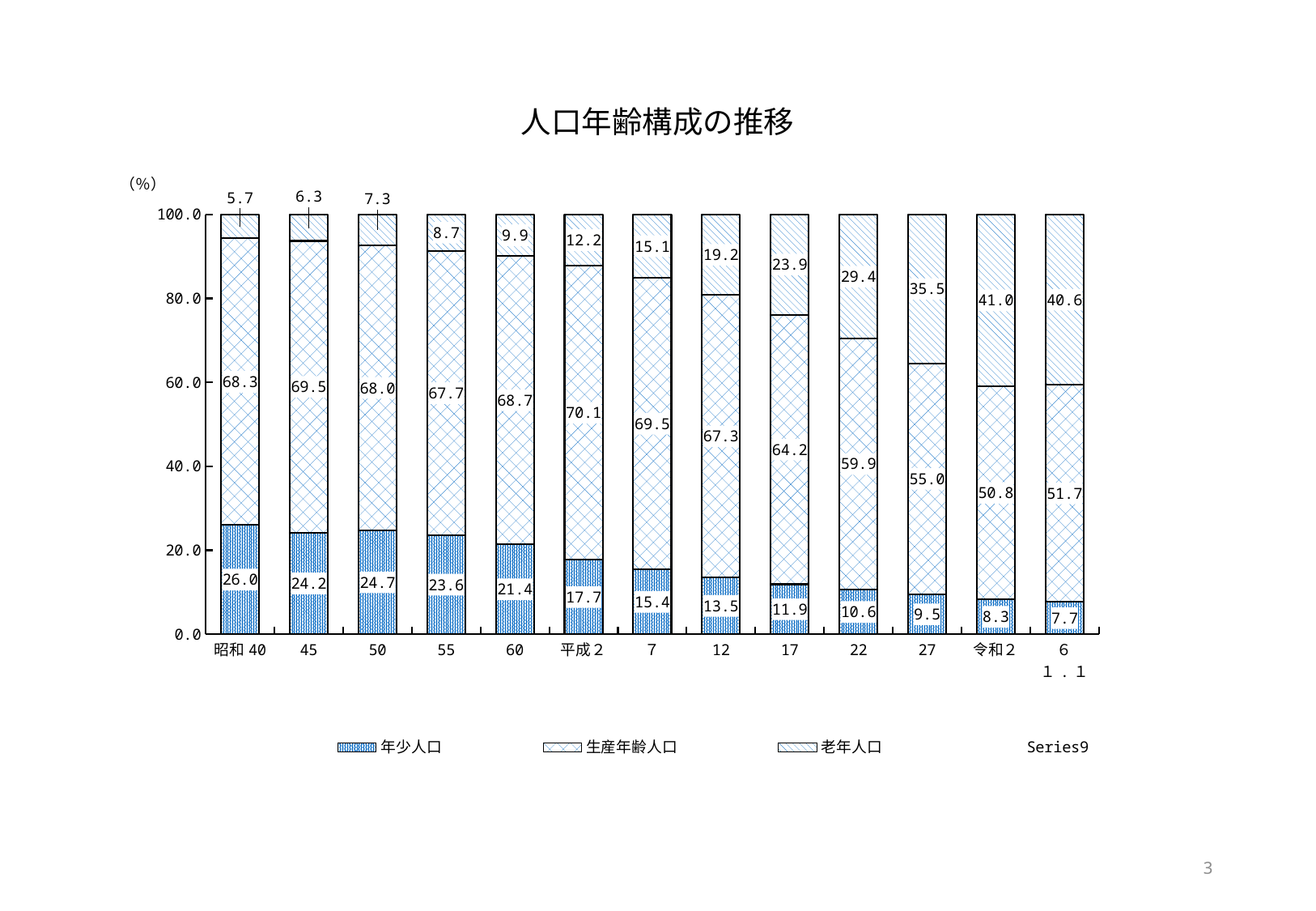
What kind of chart is shown on the slide? stacked bar chart Which category has the lowest 年少人口 value? 6 What is the value of 生産年齢人口 for 平成2? 70.1 What is the difference between the 老年人口 values for 27 and 22? 6.1 What is the value of 老年人口 for 令和2? 41.0 How many entries does the legend list? 4 Which is larger, the 生産年齢人口 value for 昭和45 or for 17? 昭和45 Which category has the highest 老年人口 value? 令和2 What is the title of the chart? 人口年齢構成の推移 Do the 年少人口 values rise or fall from 昭和40 to 6? fall How many categories are shown on the x axis? 13 What is the value of 年少人口 for 昭和40? 26.0